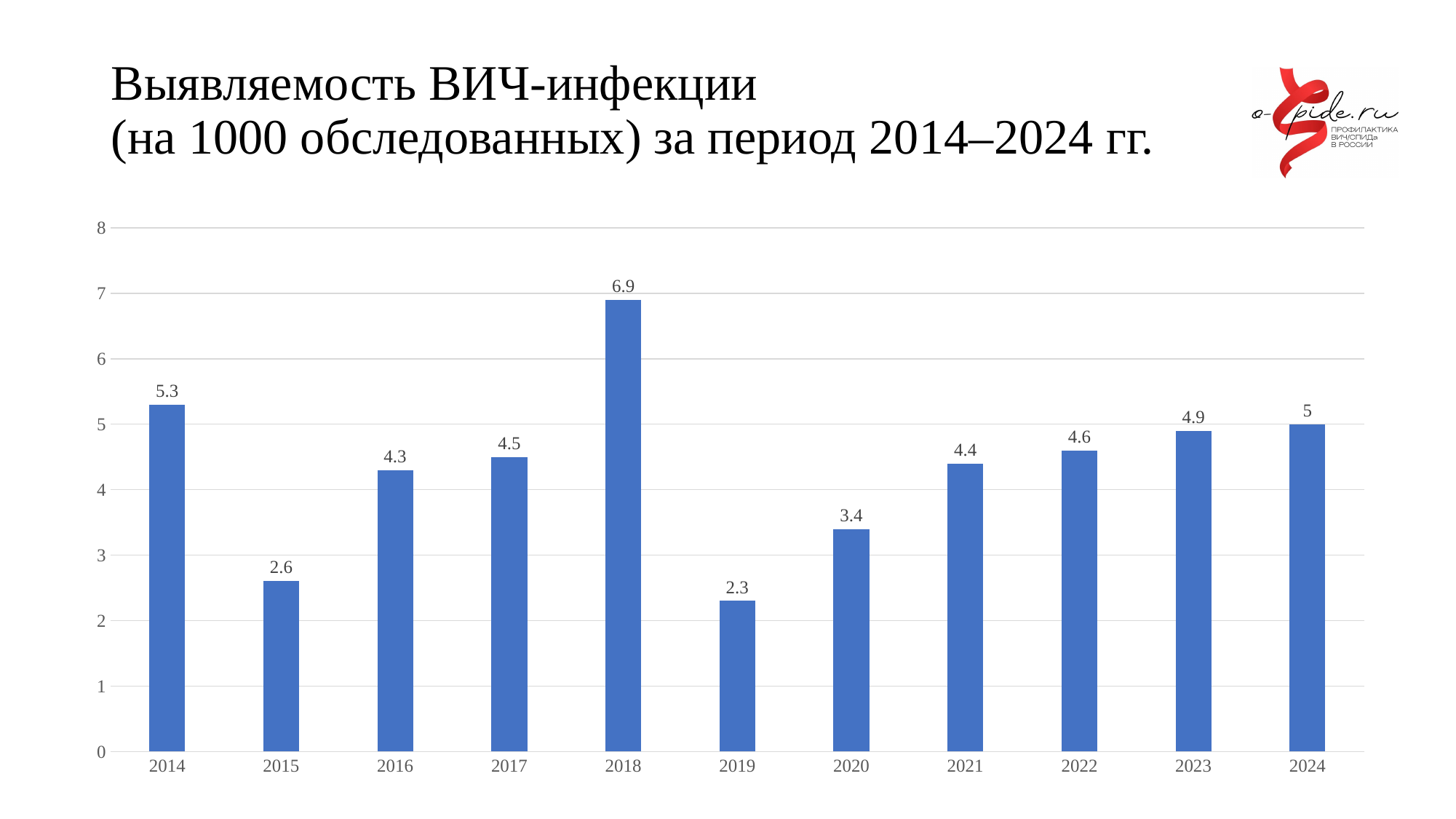
What kind of chart is shown on the slide? bar chart Which year has the lowest value? 2019 Which is larger, the value for 2014 or the value for 2023? 2014 Do the values rise or fall from 2019 to 2024? rise How many years are shown on the x axis? 11 What is the value for 2018? 6.9 Which year has the highest value? 2018 What is the difference between the values for 2018 and 2019? 4.6 What is the value for 2024? 5 What is the difference between the values for 2022 and 2021? 0.2 What is the value for 2019? 2.3 Is the value for 2020 greater or less than 3? greater